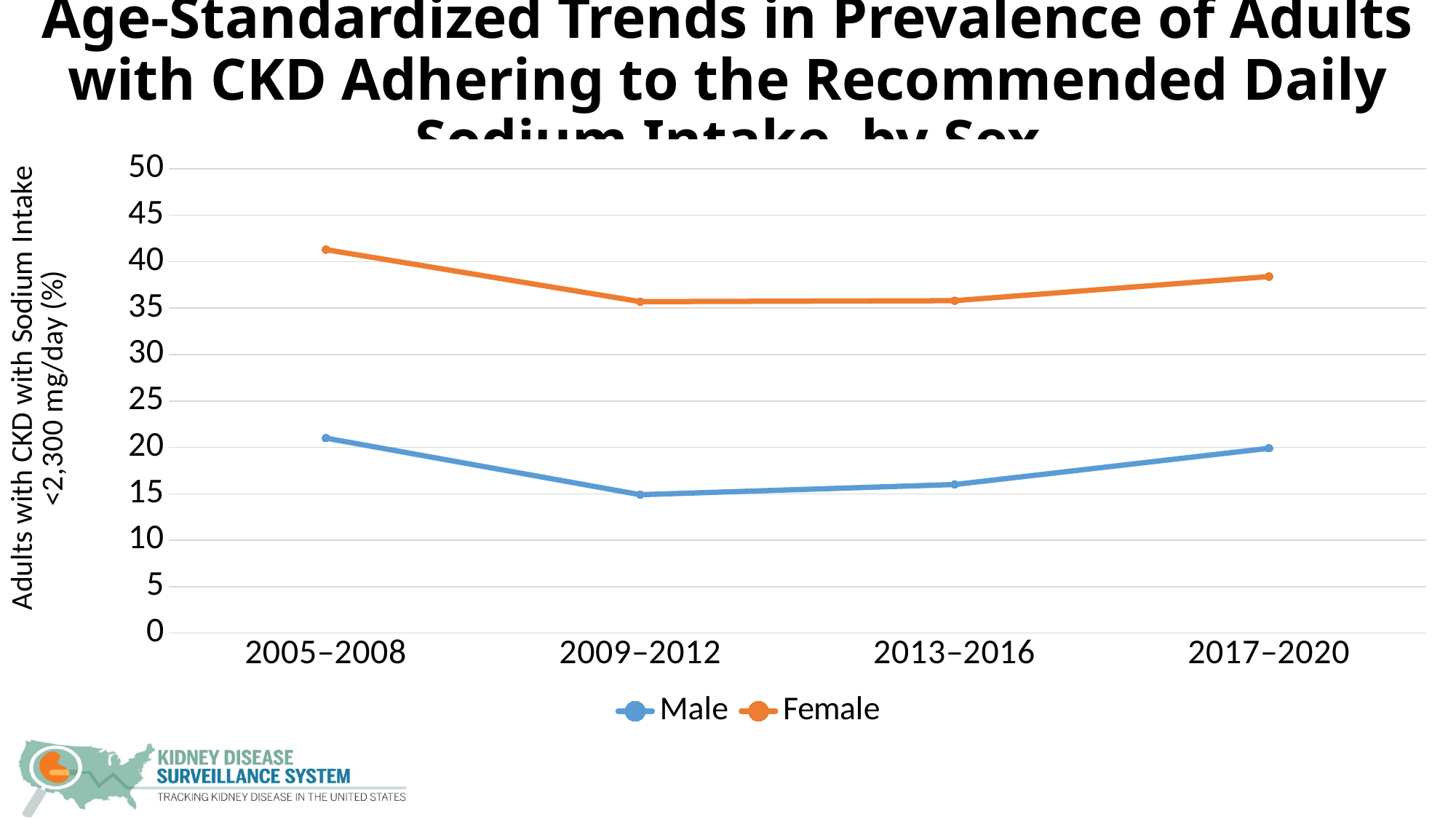
Does the Male series rise or fall from 2013–2016 to 2017–2020? Rise How many series does the legend list? 2 Is the Male value for 2017–2020 greater or less than 25? less Which series has the lower value in 2017–2020, Male or Female? Male For the Female series, which period has the highest value? 2005–2008 How many time periods are shown on the x axis? 4 What colour is the line for the Female series? Orange Is the Female value for 2017–2020 greater or less than 40? less Does the Female series rise or fall from 2005–2008 to 2009–2012? Fall Is the Female value for 2005–2008 greater or less than 40? greater What kind of chart is shown on the slide? Line chart Which series has the higher value in 2005–2008, Male or Female? Female